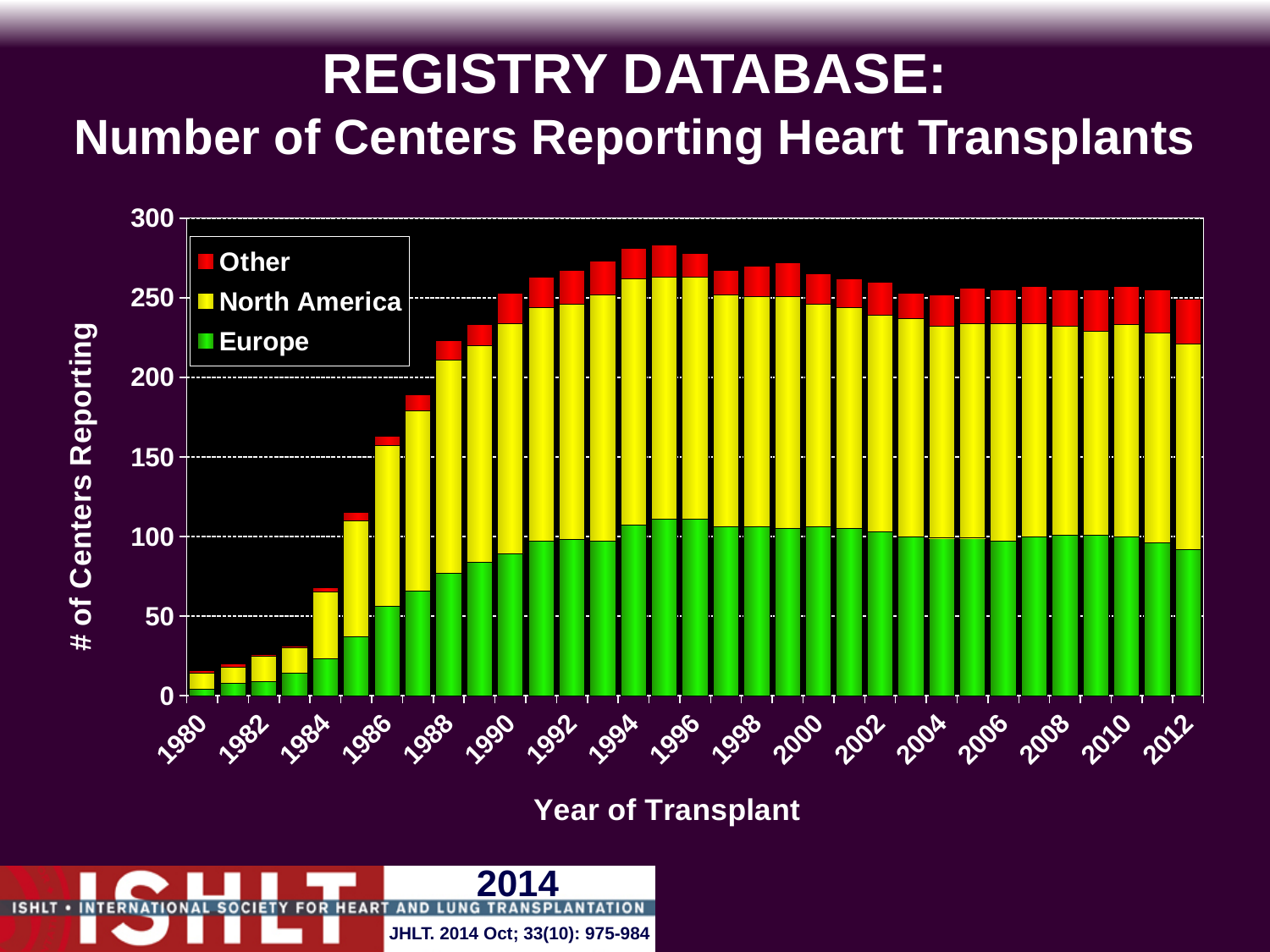
Is the total number of centers reporting in 1980 greater or less than 50? less Is the total number of centers reporting in 1990 greater or less than 200? greater Is the total number of centers reporting in 1995 greater or less than 250? greater How many series does the legend list? 3 How many years (bars) are plotted on the x axis? 33 Which year has the lowest total number of centers reporting? 1980 Which series are listed in the legend? Other, North America, Europe What is the title of the vertical axis? # of Centers Reporting Which year has a larger total number of centers reporting, 1985 or 1990? 1990 What kind of chart is shown on the slide? Stacked bar chart Does the total number of centers reporting rise or fall from 1980 to 1995? rise